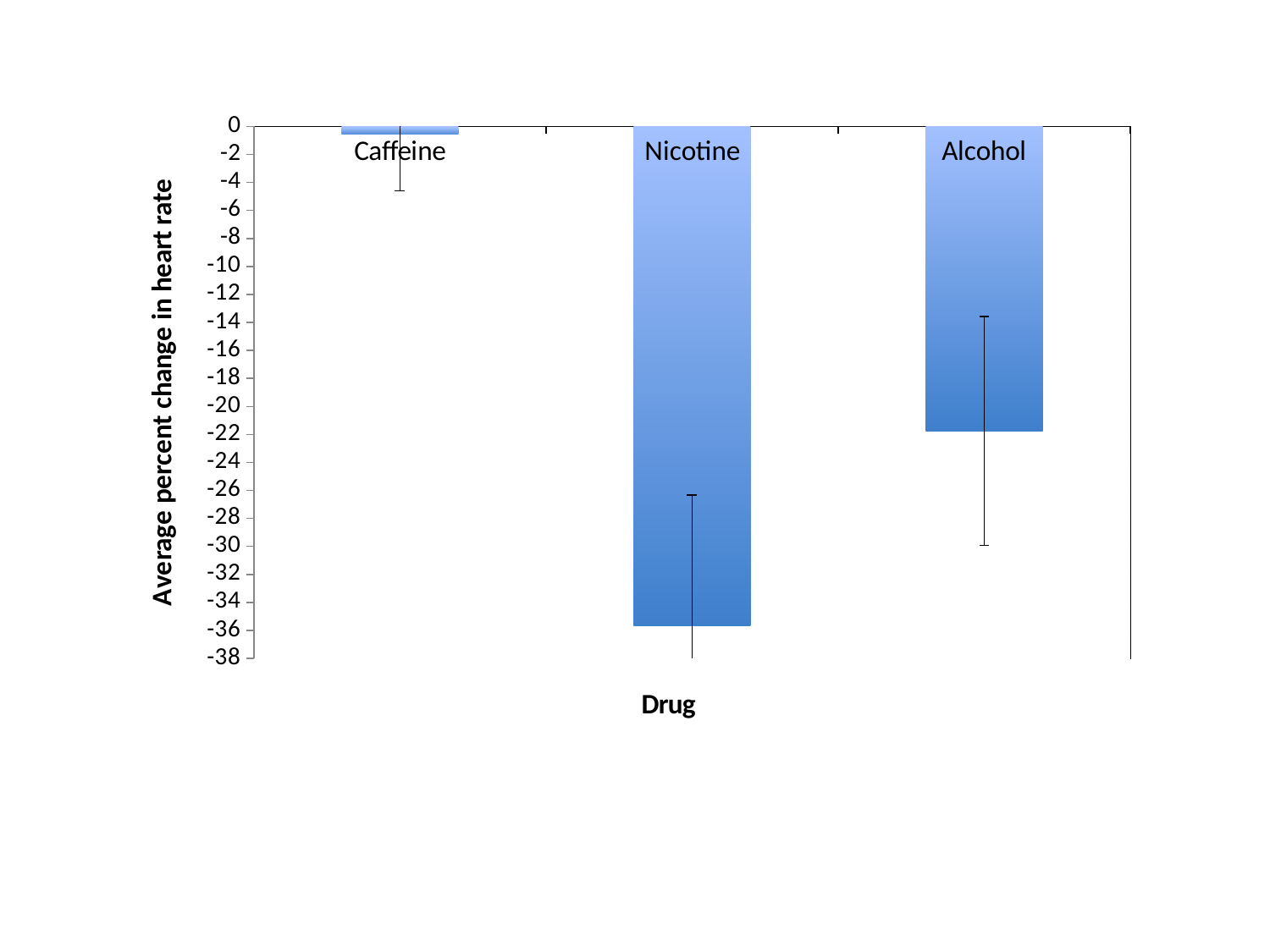
Which drug shows the largest decrease in average percent change in heart rate? Nicotine What is the title of the vertical axis? Average percent change in heart rate What is the title of the horizontal axis? Drug How many drugs (categories) are plotted in the chart? 3 Is the value for Caffeine greater or less than -2? greater Which drug shows a larger decrease in heart rate, Caffeine or Alcohol? Alcohol Is the value for Alcohol greater or less than -30? greater Which drug shows a larger decrease in heart rate, Nicotine or Alcohol? Nicotine Which drug has the highest (closest to zero) average percent change in heart rate? Caffeine What kind of chart is shown on the slide? bar chart Is the value for Nicotine greater or less than -30? less